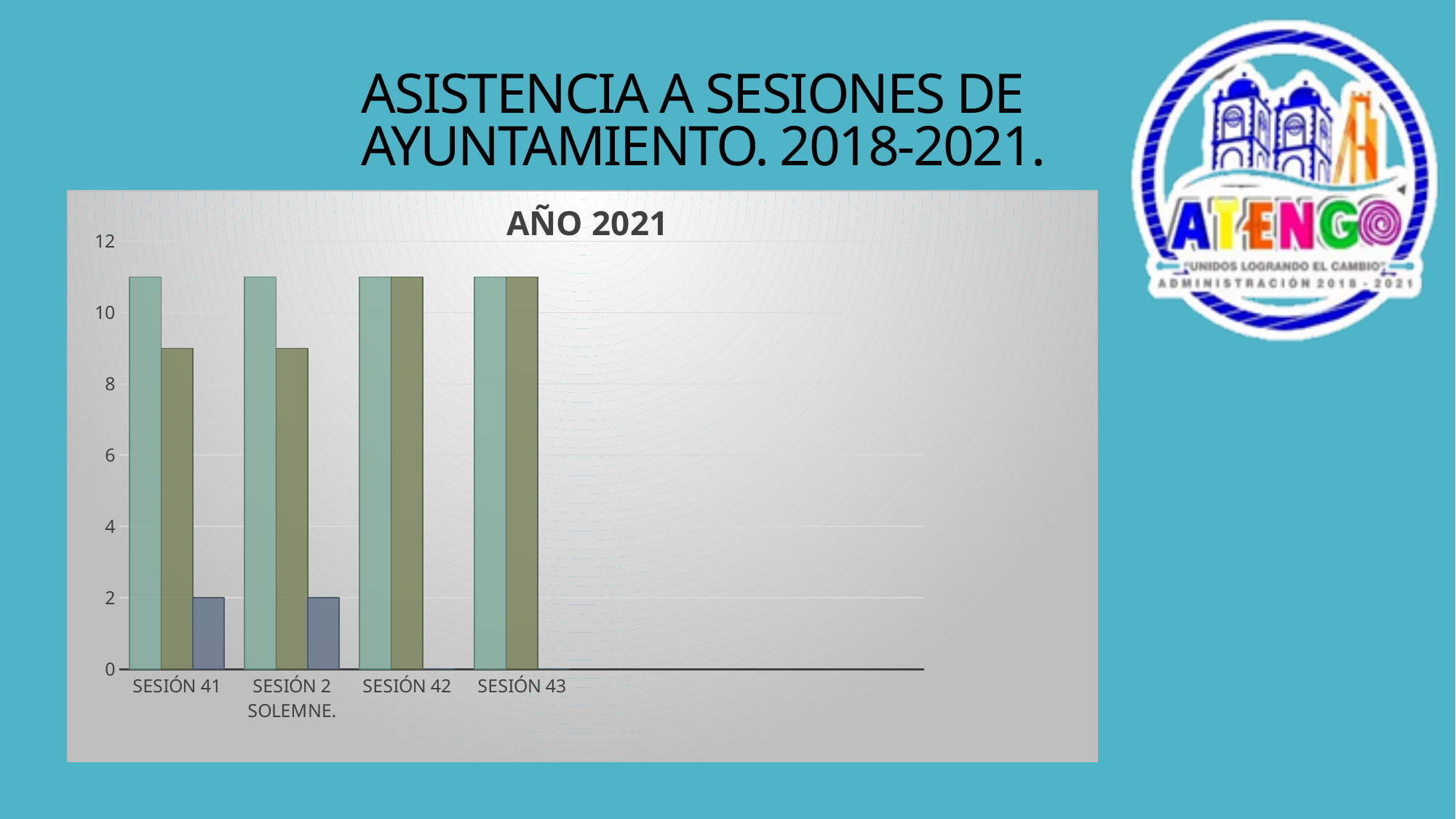
How many bars are shown for SESIÓN 41? 3 Is the value of the olive bar for SESIÓN 41 greater or less than 10? less Do the olive bars rise or fall from SESIÓN 41 to SESIÓN 43? rise Is the value of the olive bar for SESIÓN 42 greater or less than 10? greater What is the value of the dark blue-gray bar for SESIÓN 2 SOLEMNE.? 2 Which is larger: the olive bar for SESIÓN 41 or the olive bar for SESIÓN 43? SESIÓN 43 For SESIÓN 41, which is larger: the light green bar or the olive bar? the light green bar How many session categories are shown on the x axis of the chart? 4 Is the value of the light green bar for SESIÓN 41 greater or less than 10? greater What is the title of the chart? AÑO 2021 What kind of chart is shown on the slide? bar chart What is the value of the dark blue-gray bar for SESIÓN 41? 2